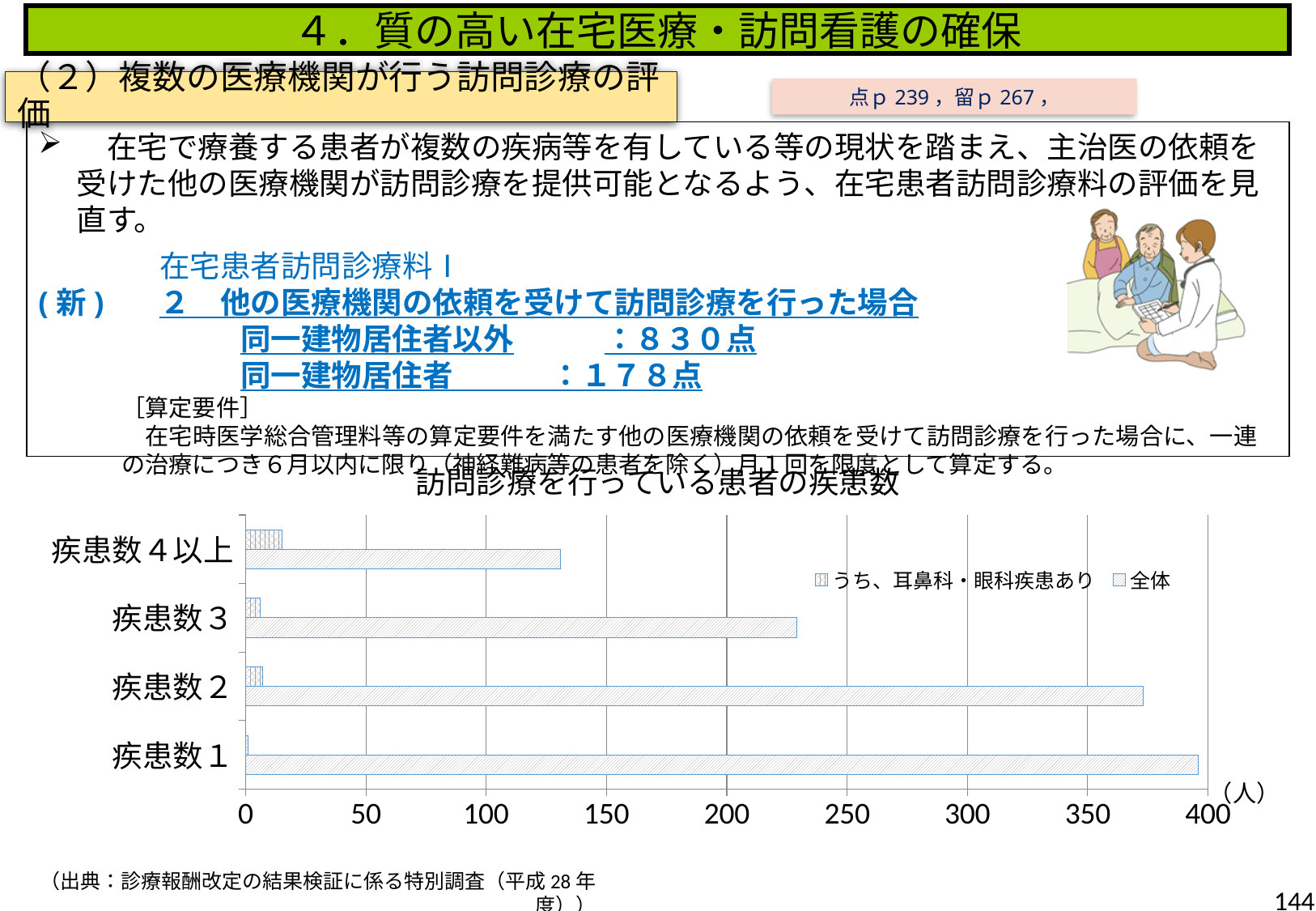
Is the 全体 value for 疾患数２ greater or less than 350? greater Is the 全体 value for 疾患数３ greater or less than 200? greater Which category has the lowest value for the 全体 series? 疾患数４以上 Which category has the highest value for the 全体 series? 疾患数１ What kind of chart is shown on the slide? bar chart How many categories are shown on the chart's vertical axis? 4 What is the title of the chart? 訪問診療を行っている患者の疾患数 How many series does the chart's legend list? 2 Is the 全体 value for 疾患数４以上 greater or less than 150? less Which is larger for the 全体 series: 疾患数２ or 疾患数３? 疾患数２ Which category has the highest value for the うち、耳鼻科・眼科疾患あり series? 疾患数４以上 What unit is shown next to the horizontal axis of the chart? （人）